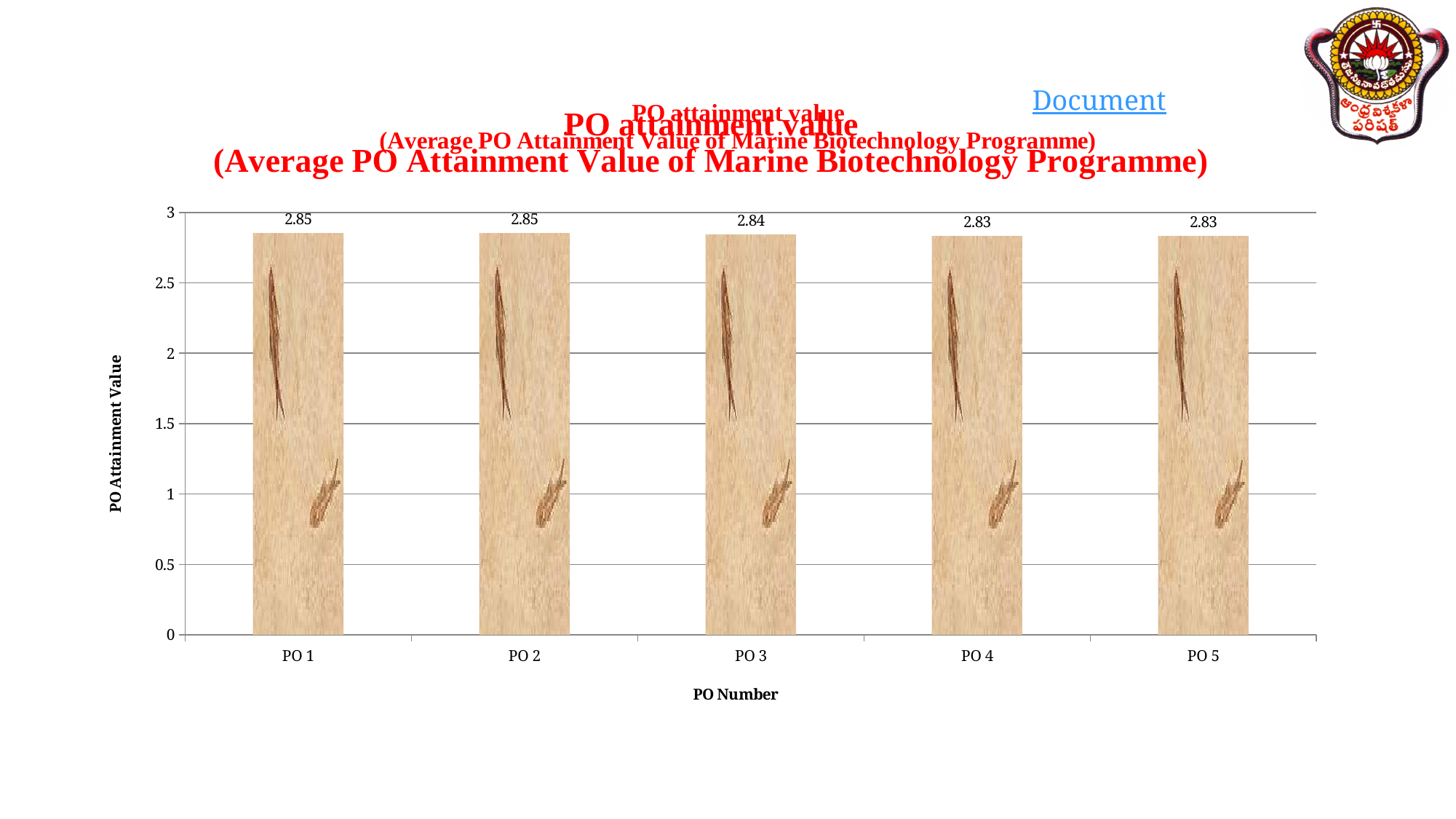
What is the PO attainment value for PO 3? 2.84 What is the difference between the values for PO 1 and PO 5? 0.02 What is the PO attainment value for PO 1? 2.85 What is the title of the vertical axis? PO Attainment Value What is the PO attainment value for PO 5? 2.83 Which has a larger value, PO 1 or PO 5? PO 1 What is the difference between the values for PO 2 and PO 3? 0.01 What is the PO attainment value for PO 4? 2.83 Do the values rise or fall from PO 1 to PO 5? fall What kind of chart is shown on the slide? bar chart Is the value for PO 3 greater or less than 2.5? greater How many PO categories are shown on the x axis? 5